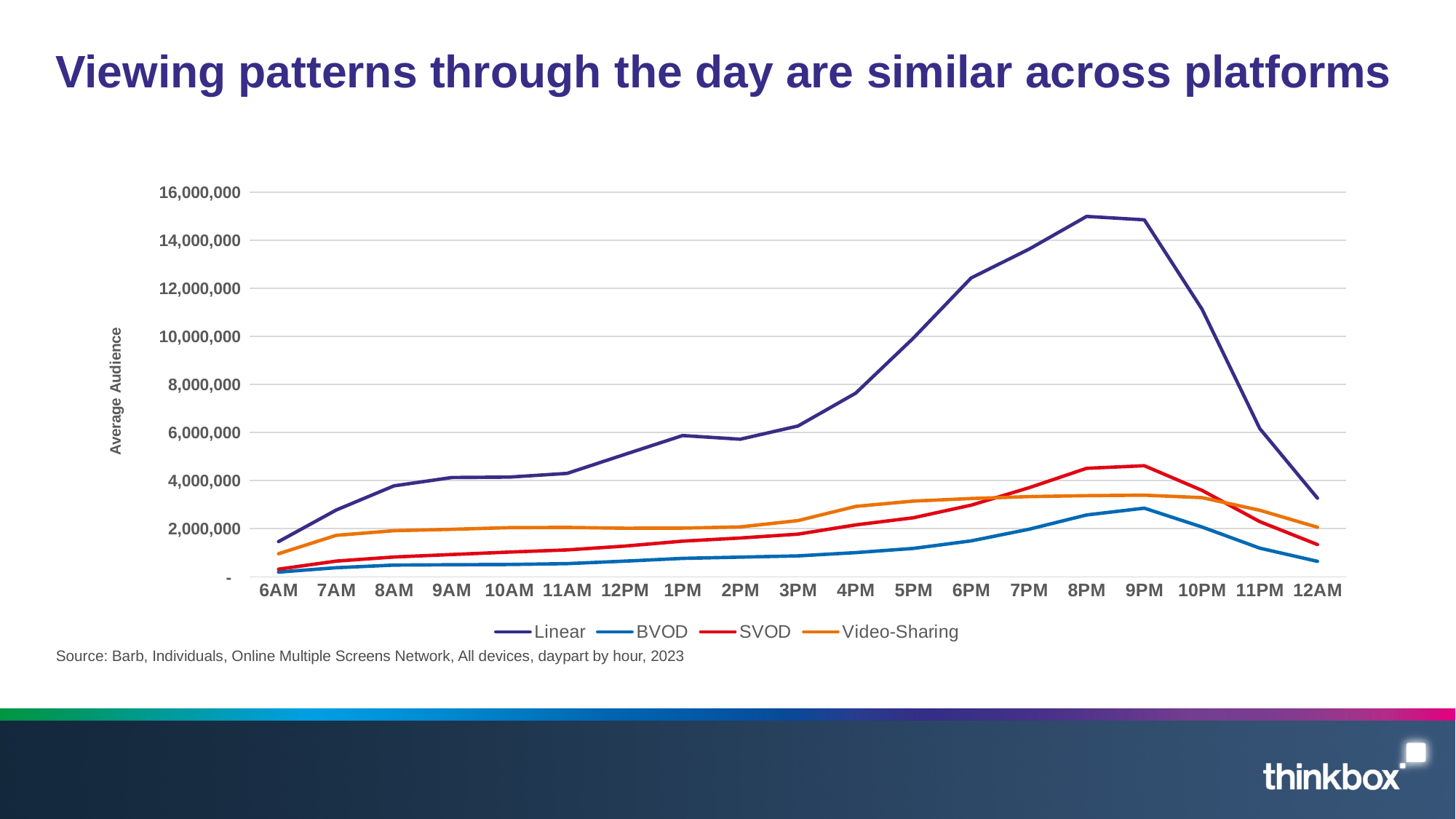
How many hourly points are plotted along the x axis? 19 What kind of chart is shown on the slide? Line chart Does the Linear series rise or fall between 9PM and 12AM? Fall Which series reaches the highest average audience at any point in the day? Linear At 6AM, which is larger: Video-Sharing or BVOD? Video-Sharing How many series does the legend list? 4 At which hour does the Linear series reach its highest value? 8PM Is the value for SVOD at 9PM greater or less than 4,000,000? greater Is the value for Linear at 8PM greater or less than 14,000,000? greater Is the value for Linear at 10PM greater or less than 10,000,000? greater At 8PM, which is larger: Linear or SVOD? Linear